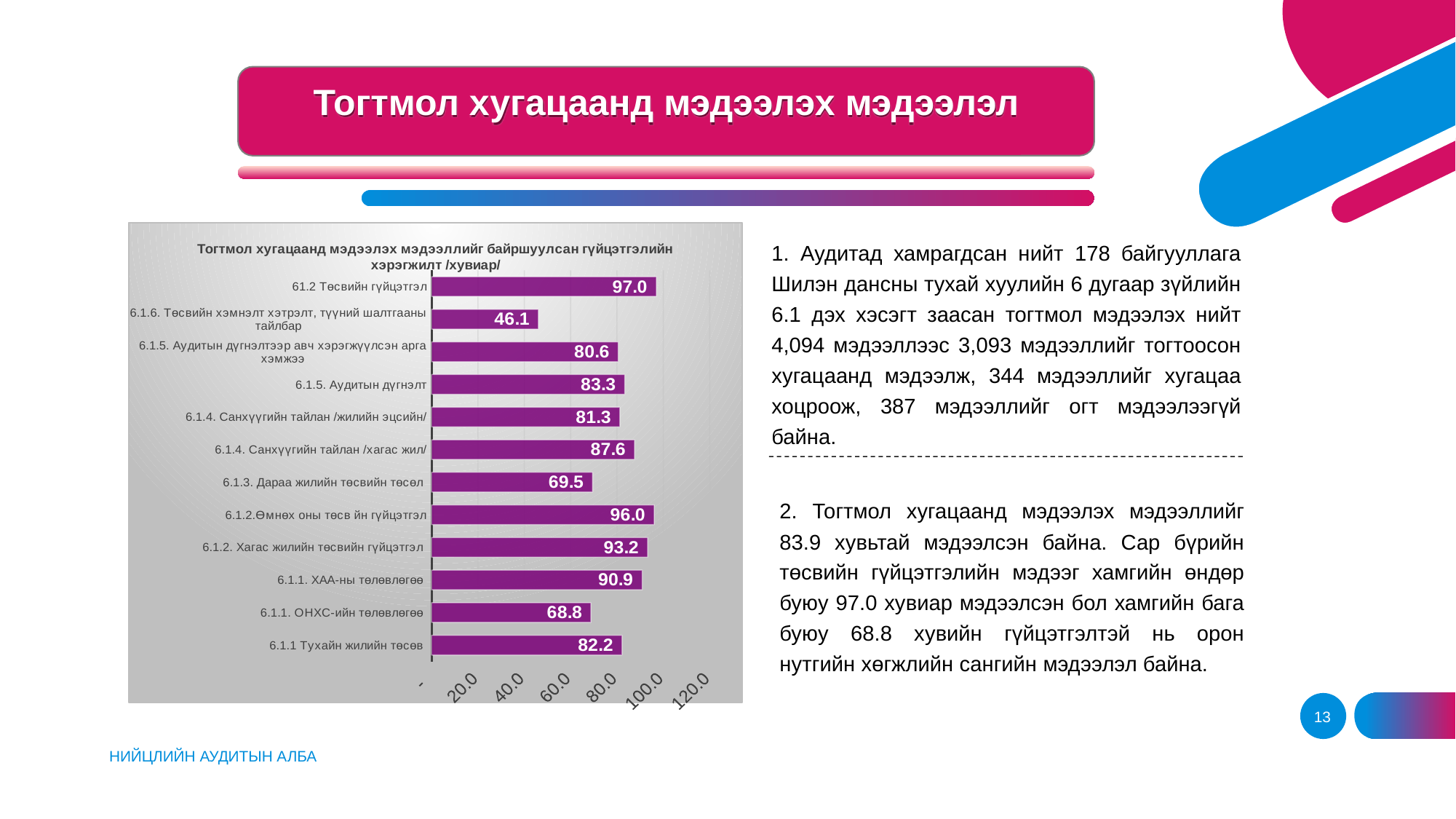
Is the value for "6.1.1. ХАА-ны төлөвлөгөө" greater or less than 80.0? greater What is the difference between the values for "6.1.2.Өмнөх оны төсв йн гүйцэтгэл" and "6.1.2. Хагас жилийн төсвийн гүйцэтгэл"? 2.8 What is the value for "6.1.3. Дараа жилийн төсвийн төсөл"? 69.5 Which is larger: the value for "6.1.5. Аудитын дүгнэлт" or the value for "6.1.1 Тухайн жилийн төсөв"? 6.1.5. Аудитын дүгнэлт What type of chart is shown on the slide? Bar chart What is the value for "6.1.1. ОНХС-ийн төлөвлөгөө"? 68.8 What is the value for "61.2 Төсвийн гүйцэтгэл"? 97.0 What is the title of the chart? Тогтмол хугацаанд мэдээлэх мэдээллийг байршуулсан гүйцэтгэлийн хэрэгжилт /хувиар/ Which category has the lowest value? 6.1.6. Төсвийн хэмнэлт хэтрэлт, түүний шалтгааны тайлбар Which category has the highest value? 61.2 Төсвийн гүйцэтгэл How many categories (bars) are shown in the chart? 12 What is the value for "6.1.4. Санхүүгийн тайлан /хагас жил/"? 87.6